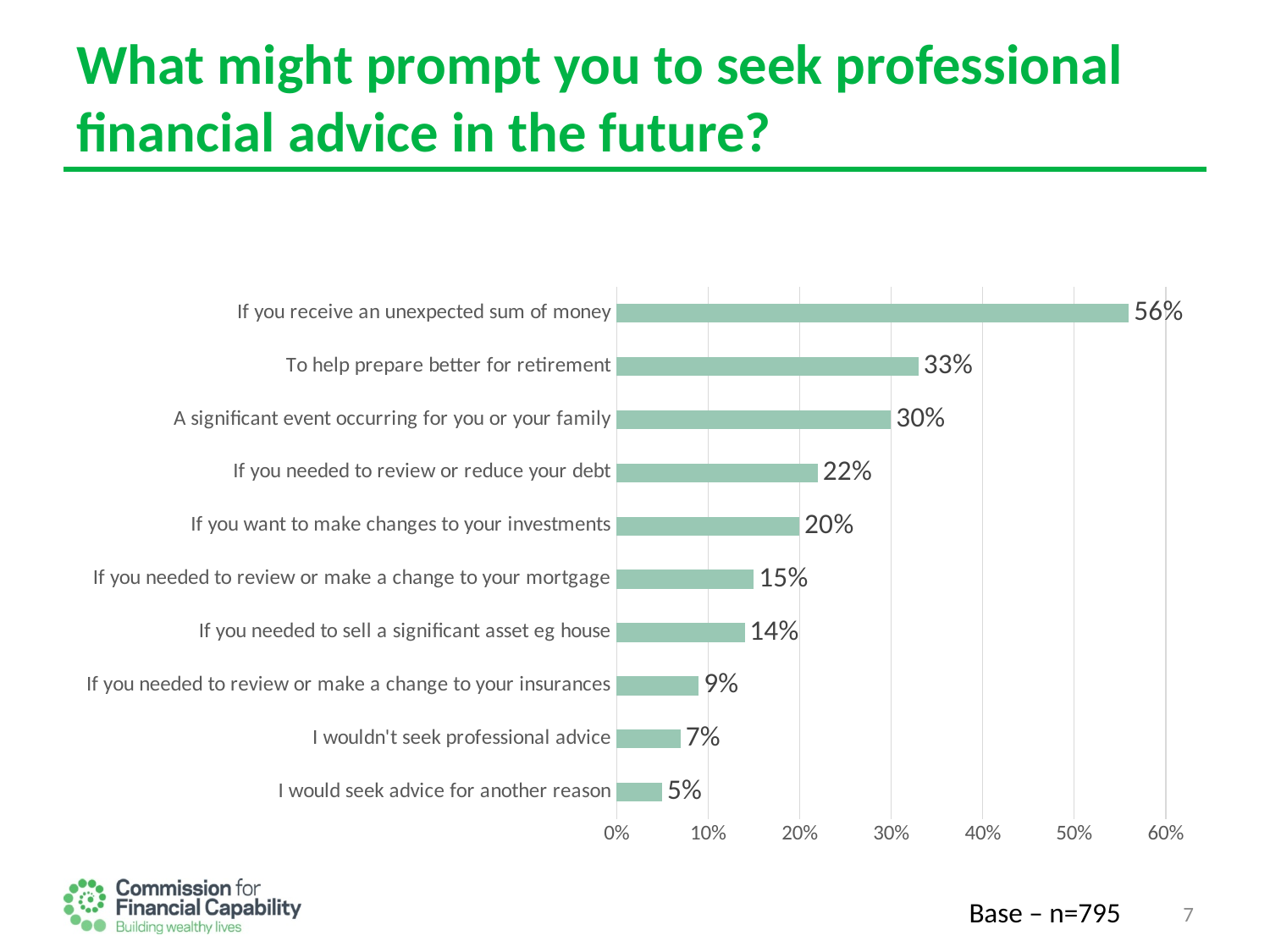
What kind of chart is shown on the slide? Bar chart Which is larger: 'If you needed to review or reduce your debt' or 'If you want to make changes to your investments'? If you needed to review or reduce your debt Which category has the lowest value on the chart? I would seek advice for another reason What percentage of respondents said receiving an unexpected sum of money might prompt them to seek professional financial advice? 56% What percentage said they wouldn't seek professional advice? 7% What is the base sample size shown on the slide? n=795 What is the difference between 'If you needed to review or make a change to your mortgage' and 'If you needed to sell a significant asset eg house'? 1% What is the value for 'To help prepare better for retirement'? 33% How many categories are shown on the chart? 10 Is the value for 'A significant event occurring for you or your family' greater or less than 20%? greater Which category has the highest value on the chart? If you receive an unexpected sum of money What is the difference between 'If you receive an unexpected sum of money' and 'To help prepare better for retirement'? 23%